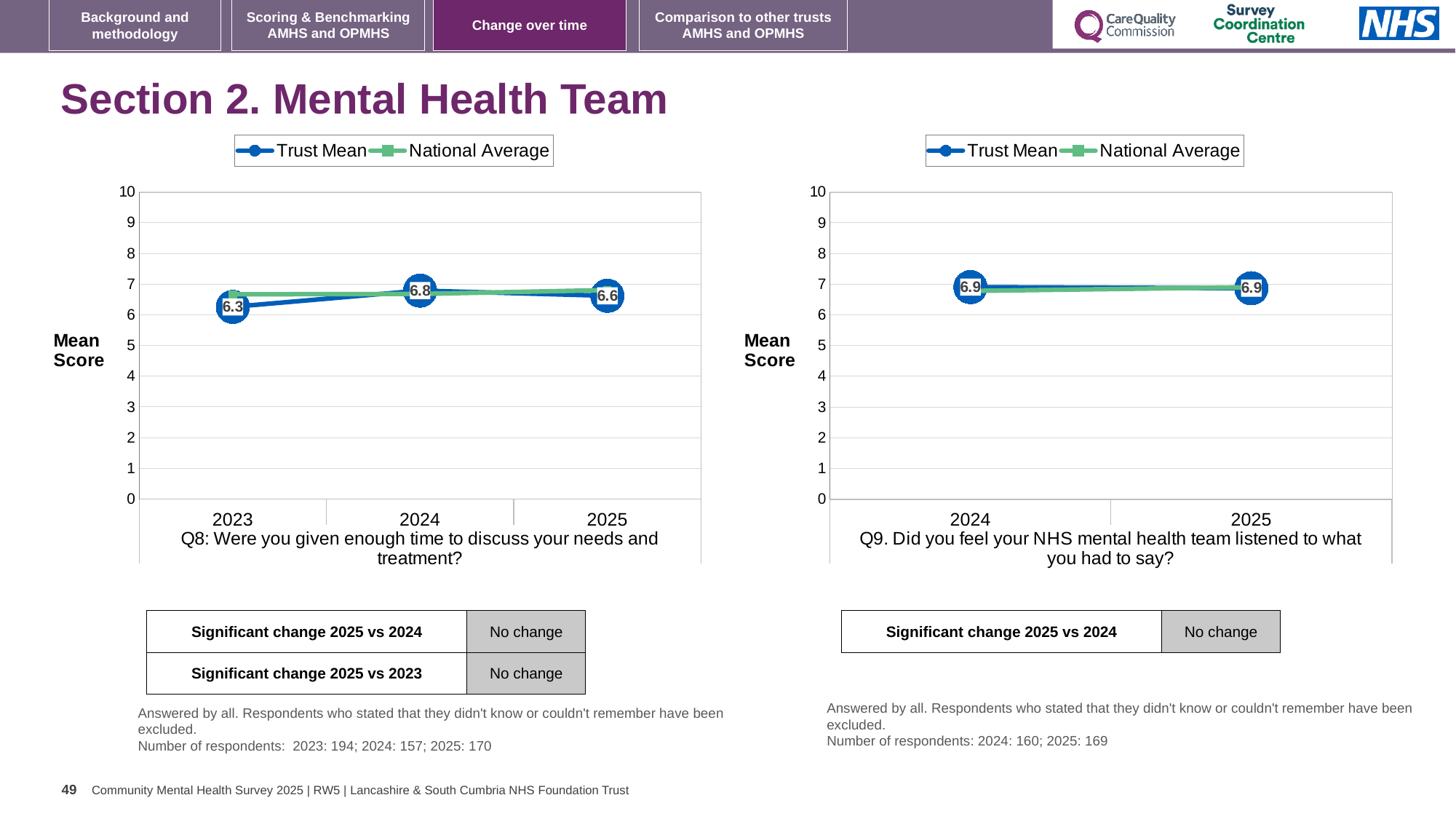
How many years are shown on the x axis of the Q9 chart on the right? 2 In the Q8 chart on the left, what is the Trust Mean for 2024? 6.8 In the Q8 chart on the left, what is the difference between the Trust Mean for 2024 and 2023? 0.5 In the Q8 chart on the left, is the Trust Mean higher in 2025 or in 2023? 2025 In the Q9 chart on the right, is the Trust Mean for 2024 greater or less than 5? greater In the Q8 chart on the left, which year has the lowest Trust Mean? 2023 In the Q8 chart on the left, what is the Trust Mean for 2025? 6.6 What kind of chart is the Q9 chart on the right? Line chart How many series does the legend of the Q8 chart on the left list? 2 In the Q8 chart on the left, which year has the highest Trust Mean? 2024 In the Q8 chart on the left, what is the Trust Mean for 2023? 6.3 In the Q9 chart on the right, what is the Trust Mean for 2025? 6.9